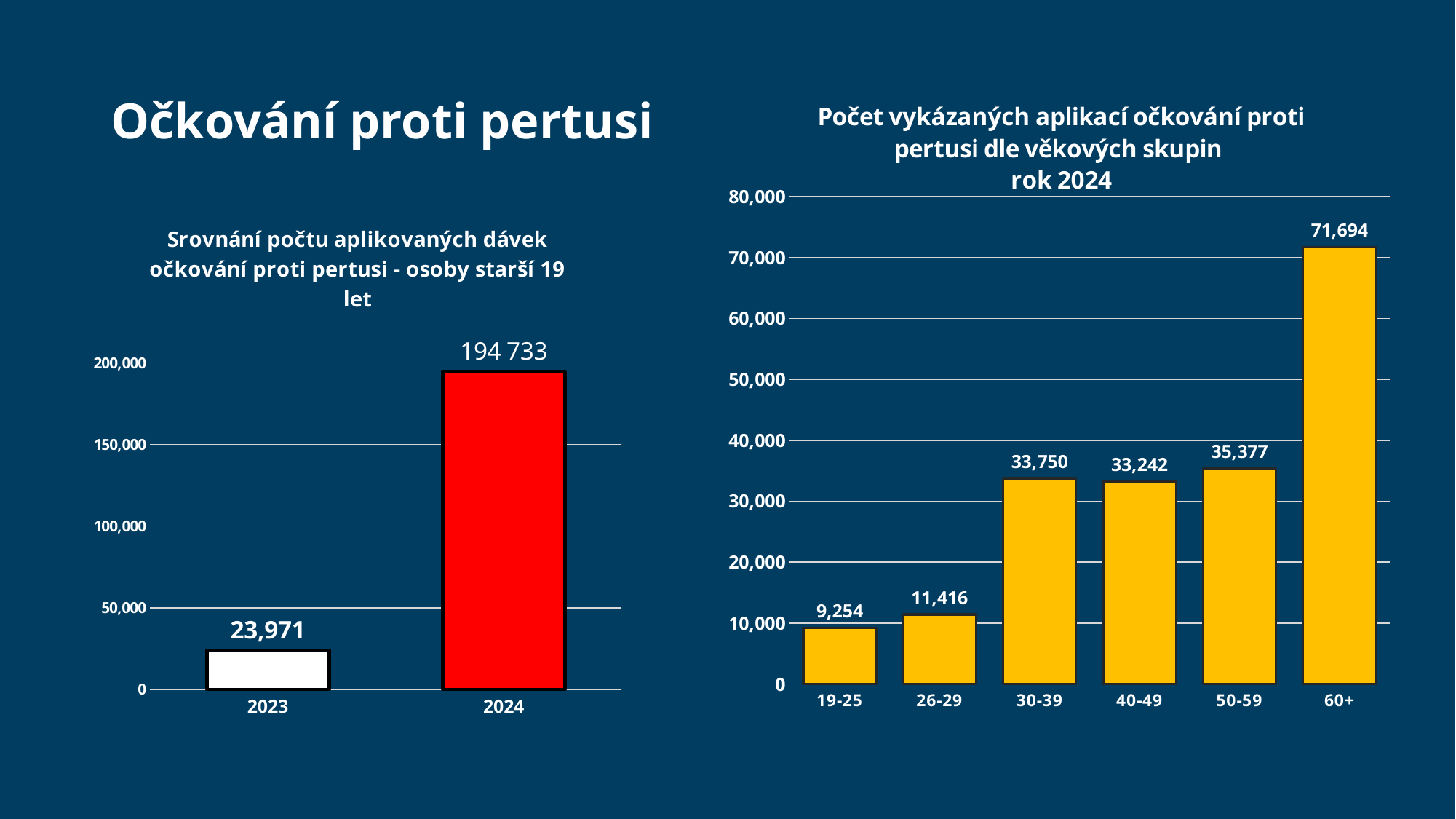
In the right chart (Počet vykázaných aplikací ... rok 2024), which age group has the highest value? 60+ In the right chart (Počet vykázaných aplikací ... rok 2024), what is the value for the 19-25 age group? 9,254 In the left chart (Srovnání počtu aplikovaných dávek), is the value for 2023 greater or less than 50,000? less In the left chart (Srovnání počtu aplikovaných dávek), what is the difference between the 2024 and 2023 values? 170,762 In the right chart (Počet vykázaných aplikací ... rok 2024), how many age groups are shown? 6 In the right chart (Počet vykázaných aplikací ... rok 2024), which is larger, the value for 50-59 or for 26-29? 50-59 In the right chart (Počet vykázaných aplikací ... rok 2024), what is the difference between the 60+ and 50-59 values? 36,317 In the left chart (Srovnání počtu aplikovaných dávek), what is the value for 2023? 23,971 In the left chart (Srovnání počtu aplikovaných dávek), what is the value for 2024? 194 733 In the right chart (Počet vykázaných aplikací ... rok 2024), what is the value for the 30-39 age group? 33,750 In the right chart (Počet vykázaných aplikací ... rok 2024), which age group has the lowest value? 19-25 What kind of chart is the right chart (Počet vykázaných aplikací ... rok 2024)? bar chart